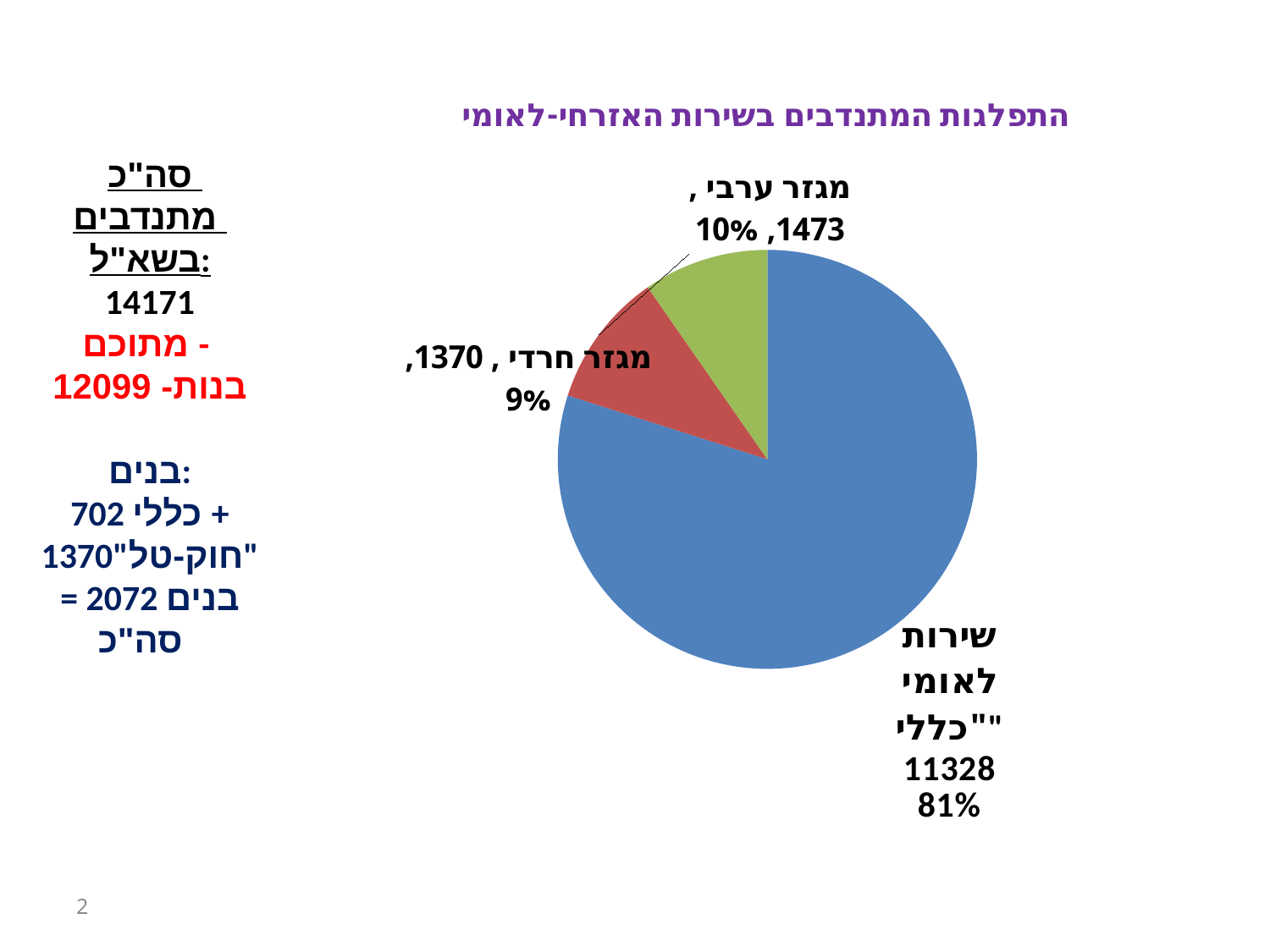
What share of the pie does the "שירות לאומי "כללי"" slice represent? 81% Which slice is the smallest in the pie chart? מגזר חרדי What share of the pie does the "מגזר חרדי" slice represent? 9% What is the value for the "שירות לאומי "כללי"" slice? 11328 What is the difference between the values for "מגזר ערבי" and "מגזר חרדי"? 103 What is the value for the "מגזר חרדי" slice? 1370 What is the value for the "מגזר ערבי" slice? 1473 Which slice is the largest in the pie chart? שירות לאומי "כללי" What kind of chart is shown on the slide? pie chart How many slices does the pie chart have? 3 What share of the pie does the "מגזר ערבי" slice represent? 10% What is the title of the pie chart? התפלגות המתנדבים בשירות האזרחי-לאומי